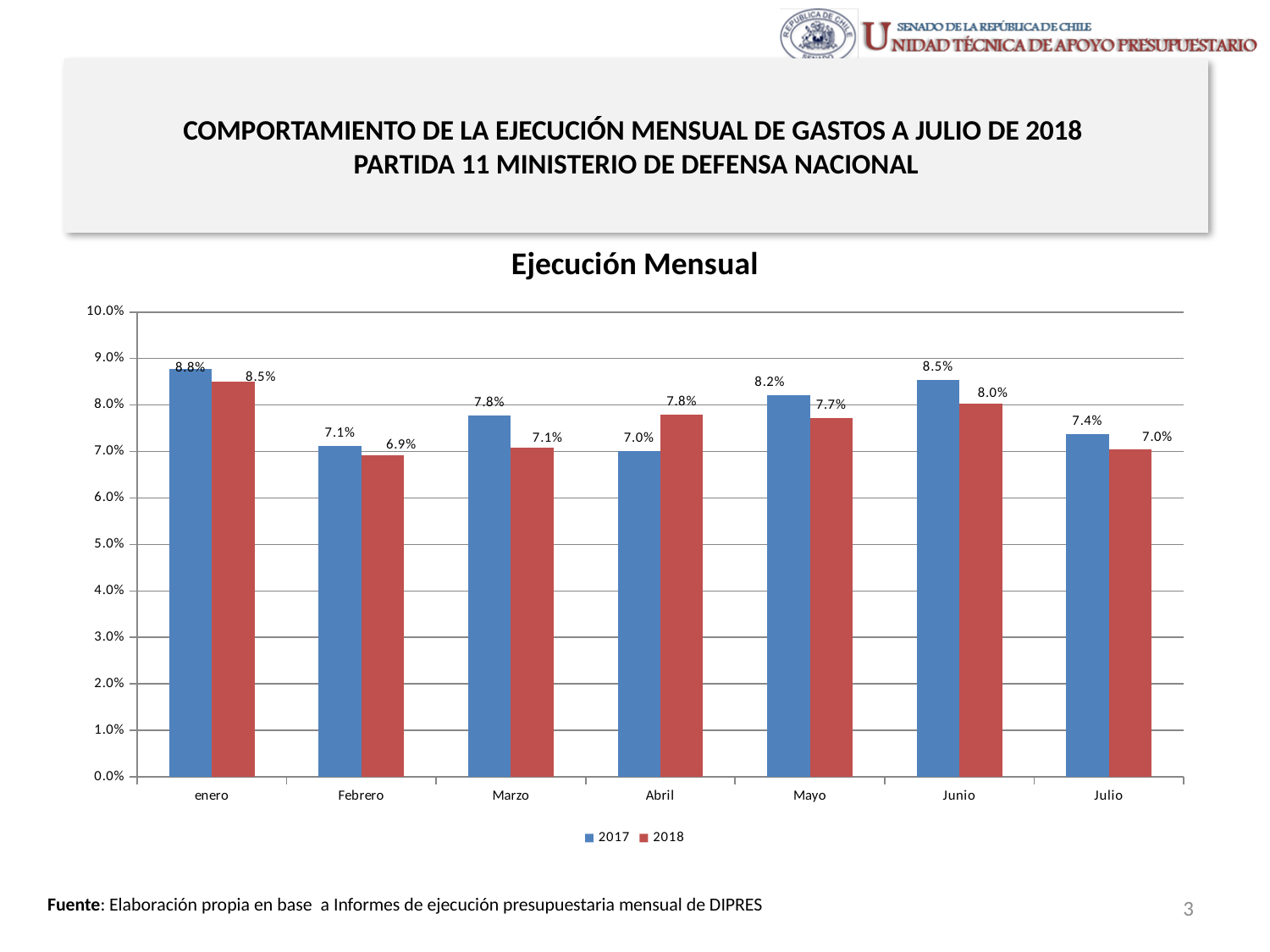
What is the difference between the 2017 and 2018 values in Marzo? 0.7 percentage points How many series does the legend list? 2 In Abril, which series has the larger value, 2017 or 2018? 2018 What is the value for 2017 in enero? 8.8% Which month has the highest value for the 2017 series? enero Which month has the lowest value for the 2018 series? Febrero What kind of chart is shown? bar chart Is the value for 2017 in Mayo greater or less than 8.0%? greater Does the 2017 series rise or fall from Abril to Junio? rise What is the value for 2018 in Junio? 8.0% What is the value for 2018 in Abril? 7.8% How many months are shown on the x axis? 7